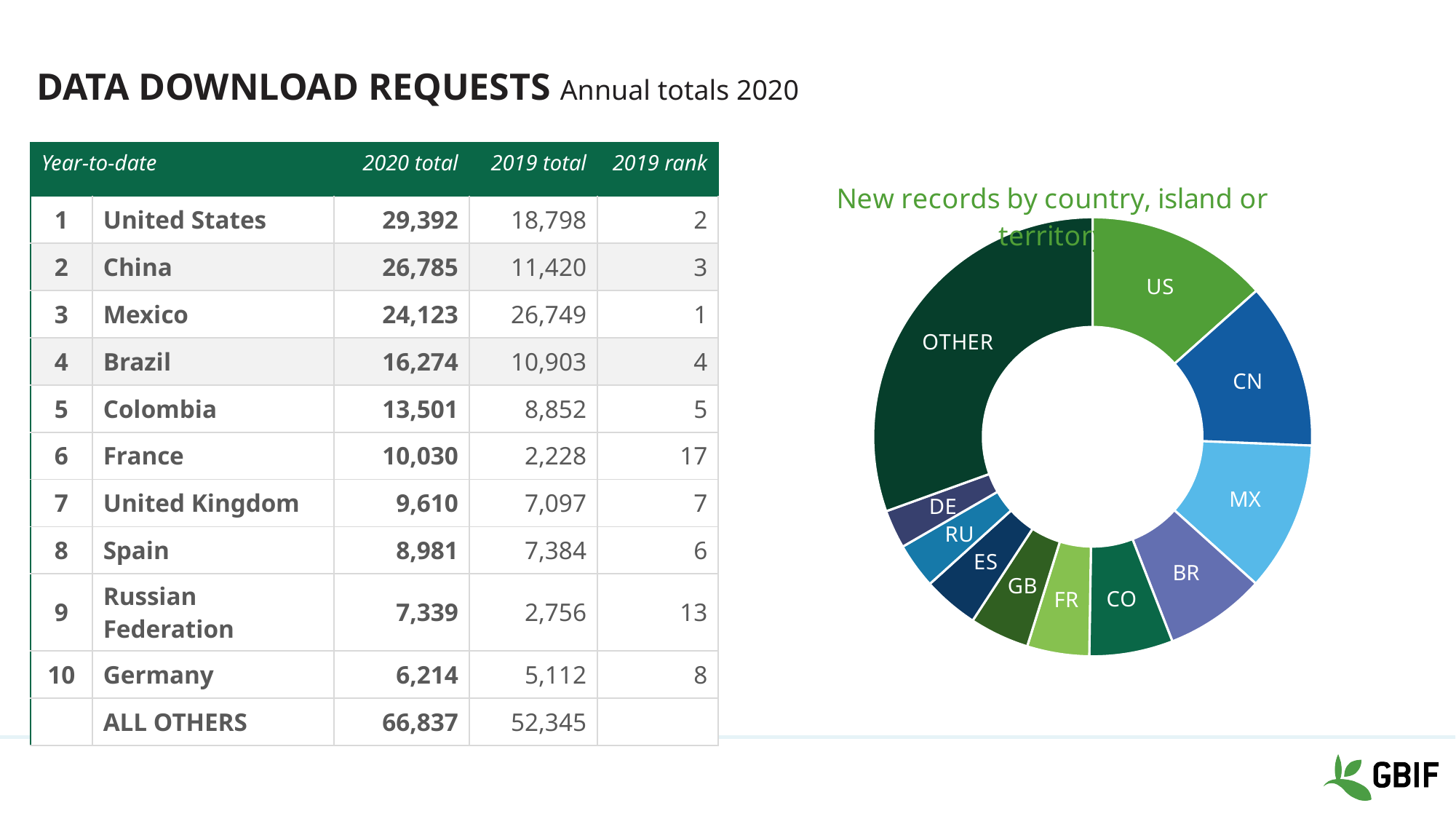
What colour is the US slice in the donut chart? Green How many slices does the donut chart have? 11 In the donut chart, which slice is larger, US or DE? US Which slice of the donut chart is labelled with the country code for Colombia? CO In the donut chart, which slice is larger, BR or GB? BR In the donut chart, which slice is larger, OTHER or CN? OTHER What kind of chart is shown on the right of the slide? Pie chart (donut) Which slice of the donut chart is the largest? OTHER